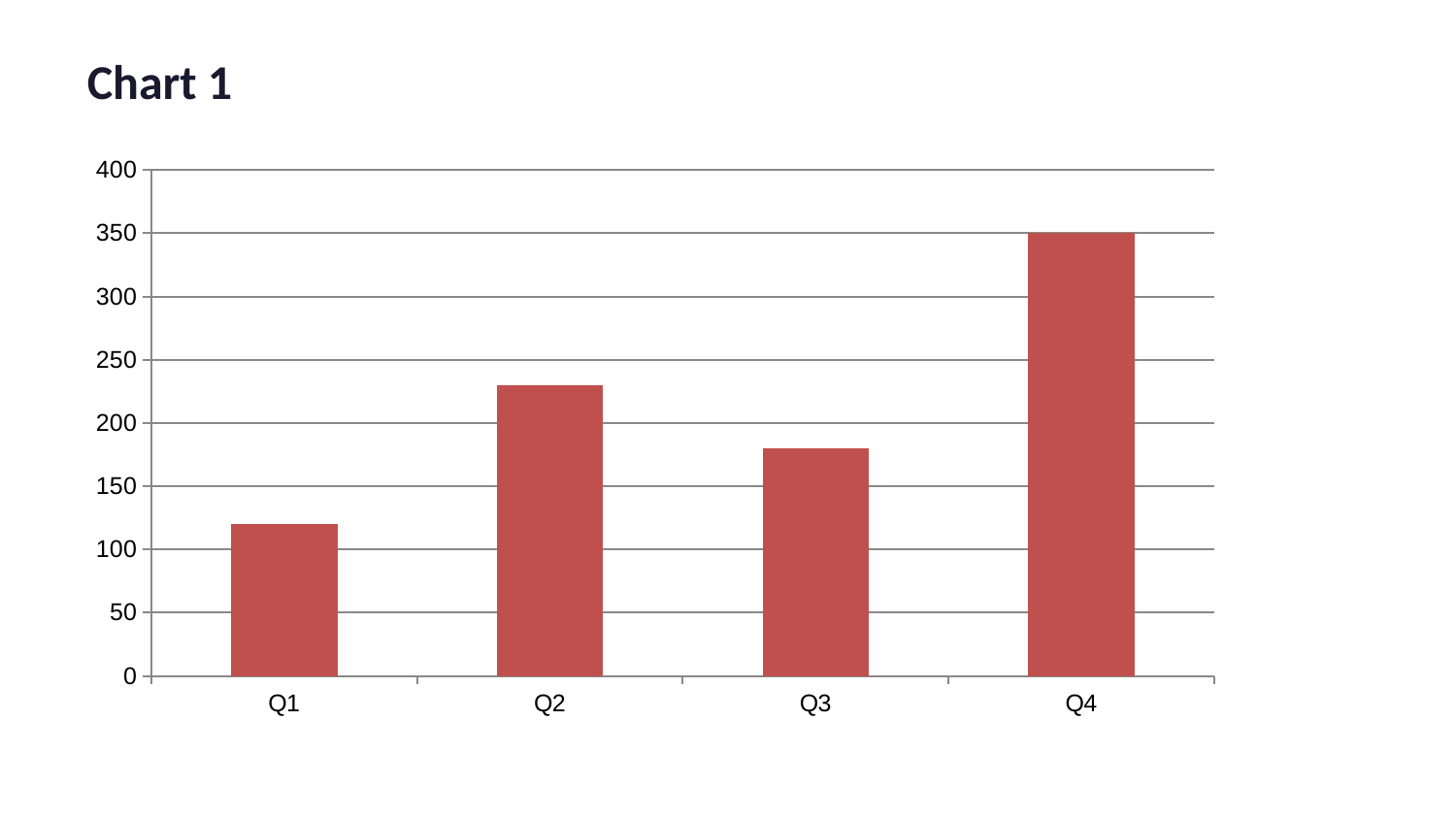
What is the highest value shown on the y axis? 400 Is the value for Q1 greater or less than 150? less Is the value for Q4 greater or less than 300? greater What is the title of the chart? Chart 1 Is the value for Q1 greater or less than 100? greater Which quarter has the lowest value? Q1 How many categories are shown on the x axis? 4 What kind of chart is shown on the slide? bar chart Which is larger, the value for Q2 or the value for Q3? Q2 Which quarter has the highest value? Q4